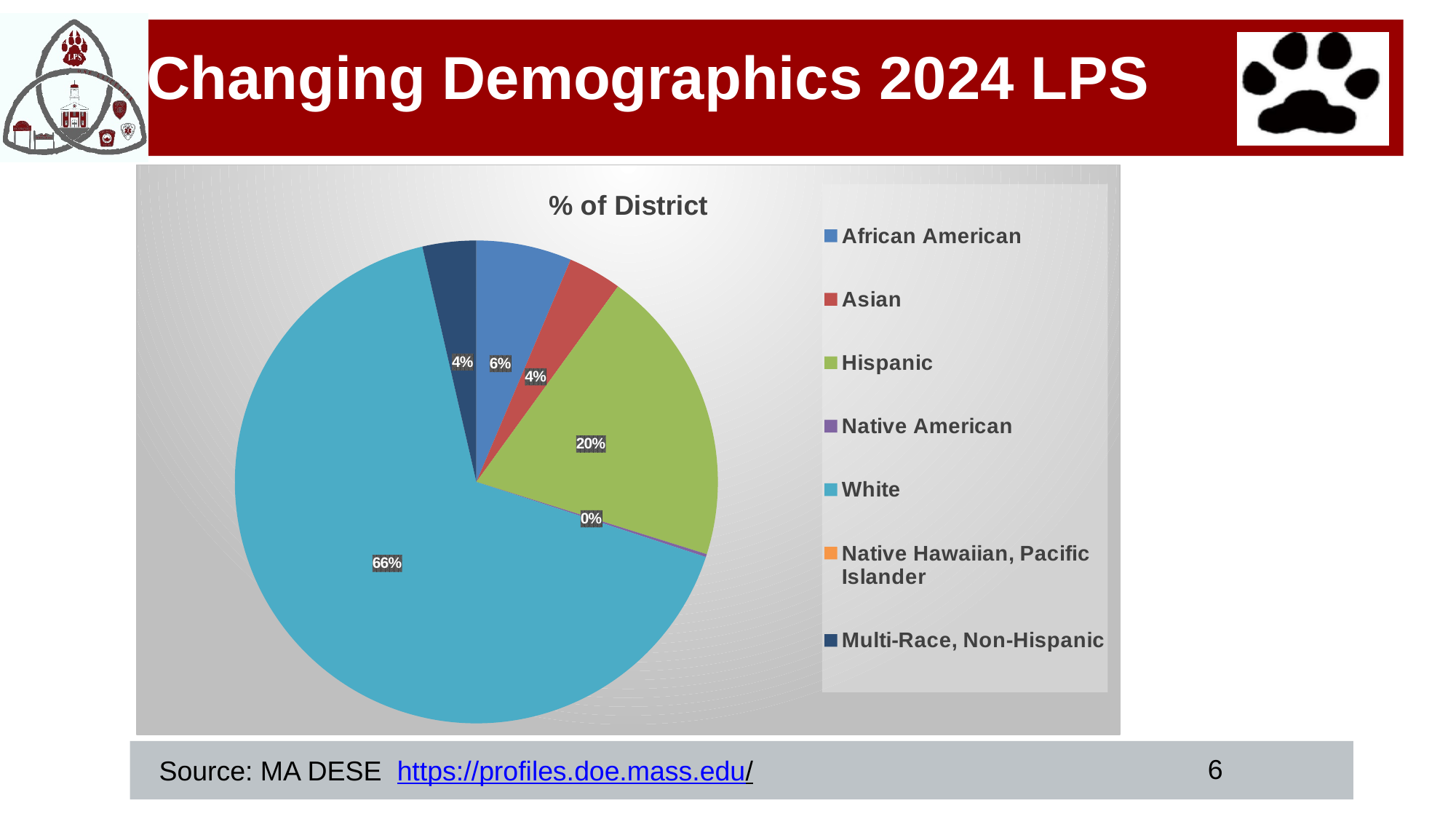
How many groups does the legend list? 7 How many percentage points larger is the White share than the Hispanic share? 46 What percentage of the district is White according to the pie chart? 66% What percentage of the district is African American? 6% What kind of chart is shown on the slide? Pie chart Which group makes up the largest share of the district? White What percentage of the district is Asian? 4% What percentage of the district is Multi-Race, Non-Hispanic? 4% What percentage of the district is Native American? 0% What is the title of the chart? % of District Which is larger, the Hispanic share or the African American share? Hispanic What percentage of the district is Hispanic? 20%